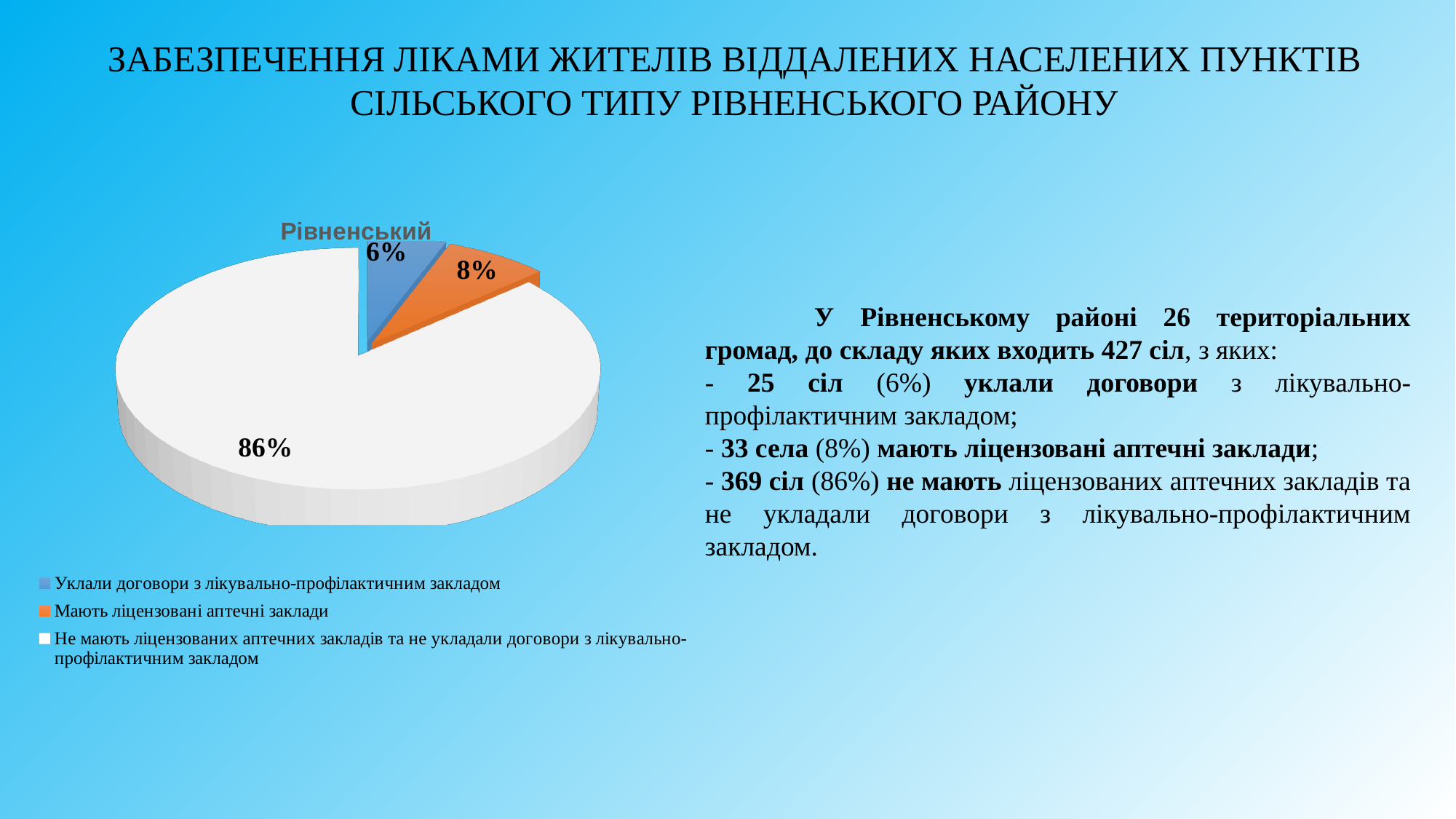
Which category has the largest slice of the pie? Не мають ліцензованих аптечних закладів та не укладали договори з лікувально-профілактичним закладом What share of the pie is labelled for 'Не мають ліцензованих аптечних закладів та не укладали договори з лікувально-профілактичним закладом'? 86% What share of the pie is labelled for 'Мають ліцензовані аптечні заклади'? 8% What is the difference in percentage points between the 86% slice and the 8% slice? 78 Which category has the smallest slice of the pie? Уклали договори з лікувально-профілактичним закладом How many slices does the pie chart have? 3 What colour is the slice for 'Мають ліцензовані аптечні заклади'? Orange Which slice is larger: 'Мають ліцензовані аптечні заклади' or 'Уклали договори з лікувально-профілактичним закладом'? Мають ліцензовані аптечні заклади What share of the pie is labelled for 'Уклали договори з лікувально-профілактичним закладом'? 6% What kind of chart is shown on the slide? Pie chart What is the title of the pie chart? Рівненський How many entries does the legend of the pie chart list? 3